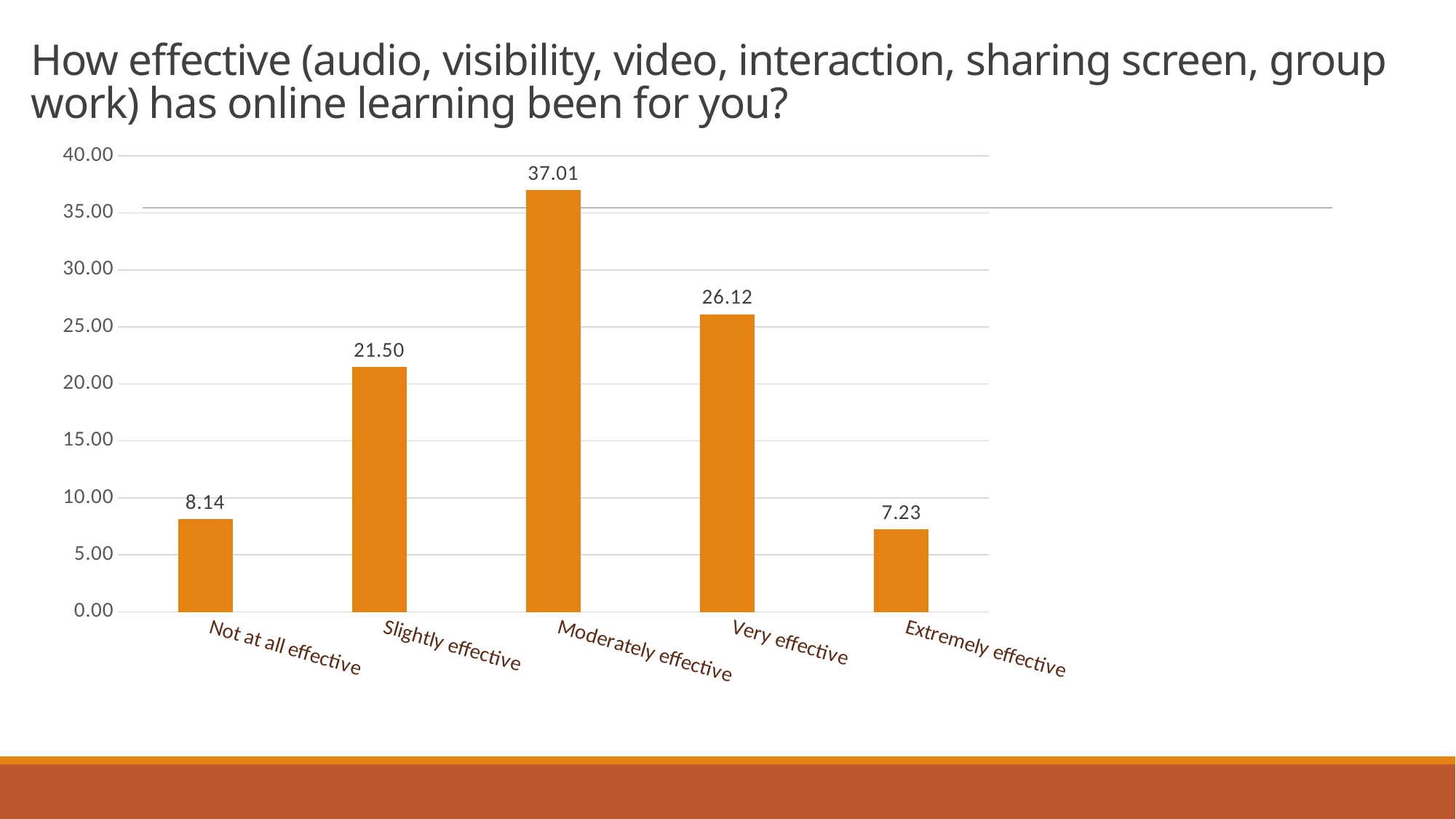
What is the value for Not at all effective? 8.14 What kind of chart is shown on the slide? bar chart Which category has the lowest value? Extremely effective How many categories are shown on the x axis? 5 What is the value for Slightly effective? 21.50 What is the difference between the values for Moderately effective and Very effective? 10.89 What is the value for Extremely effective? 7.23 What colour are the bars in the chart? orange Which category has the highest value? Moderately effective Is the value for Very effective greater or less than 25.00? greater Which is larger, the value for Slightly effective or the value for Very effective? Very effective What is the value for Moderately effective? 37.01